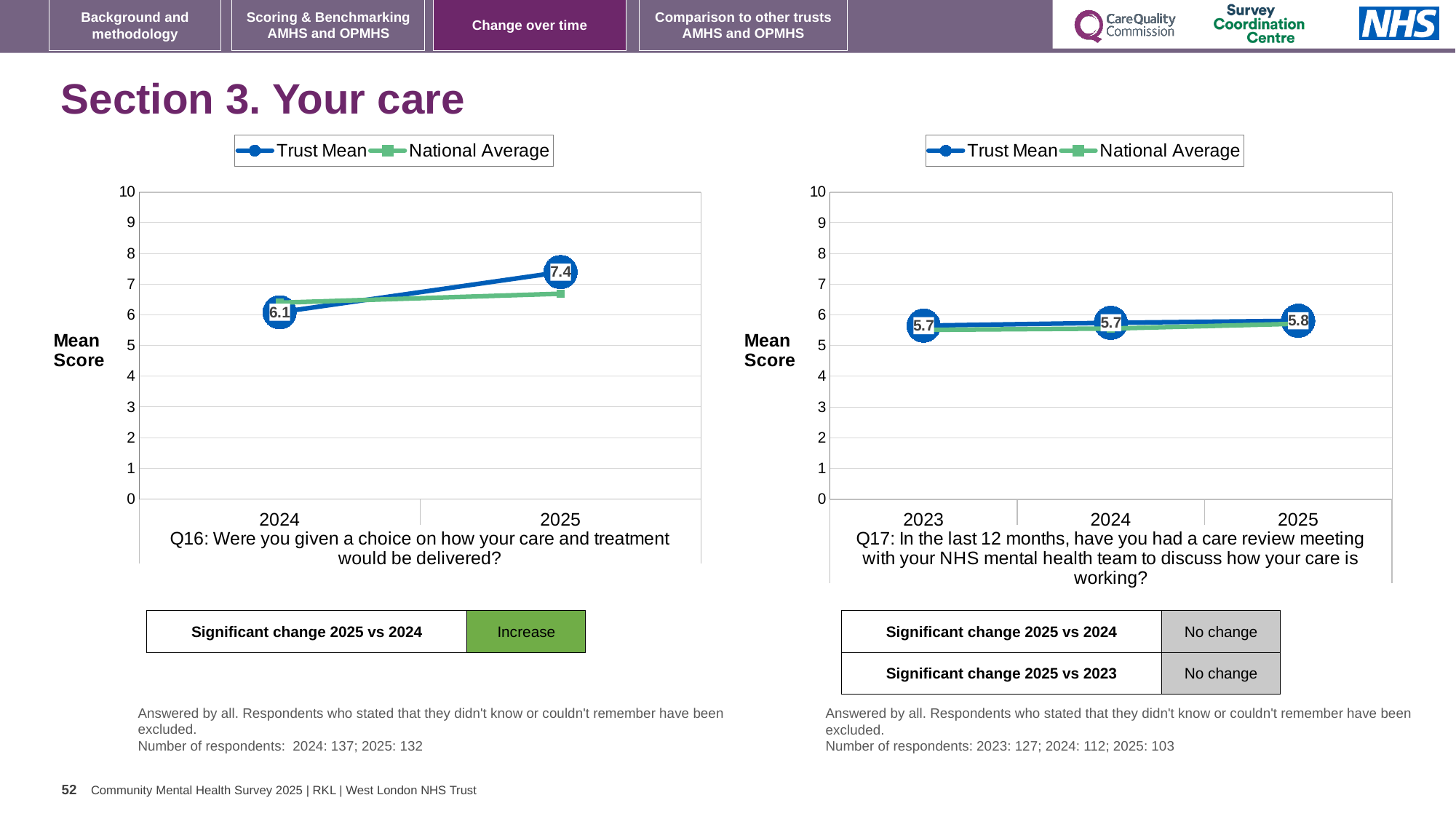
In the Q17 chart on the right, what is the Trust Mean for 2025? 5.8 In the Q17 chart on the right, is the National Average for 2024 greater or less than 5? greater In the Q17 chart on the right, what is the label of the y axis? Mean Score In the Q16 chart on the left, what is the Trust Mean for 2025? 7.4 In the Q17 chart on the right, how many years are shown on the x axis? 3 In the Q16 chart on the left, does the Trust Mean rise or fall from 2024 to 2025? rise In the Q17 chart on the right, what is the Trust Mean for 2023? 5.7 In the Q16 chart on the left, what is the Trust Mean for 2024? 6.1 In the Q16 chart on the left, by how much did the Trust Mean change from 2024 to 2025? 1.3 In the Q16 chart on the left, is the National Average for 2025 greater or less than 6? greater What type of chart is the Q16 chart on the left? line chart In the Q17 chart on the right, how many series does the legend list? 2